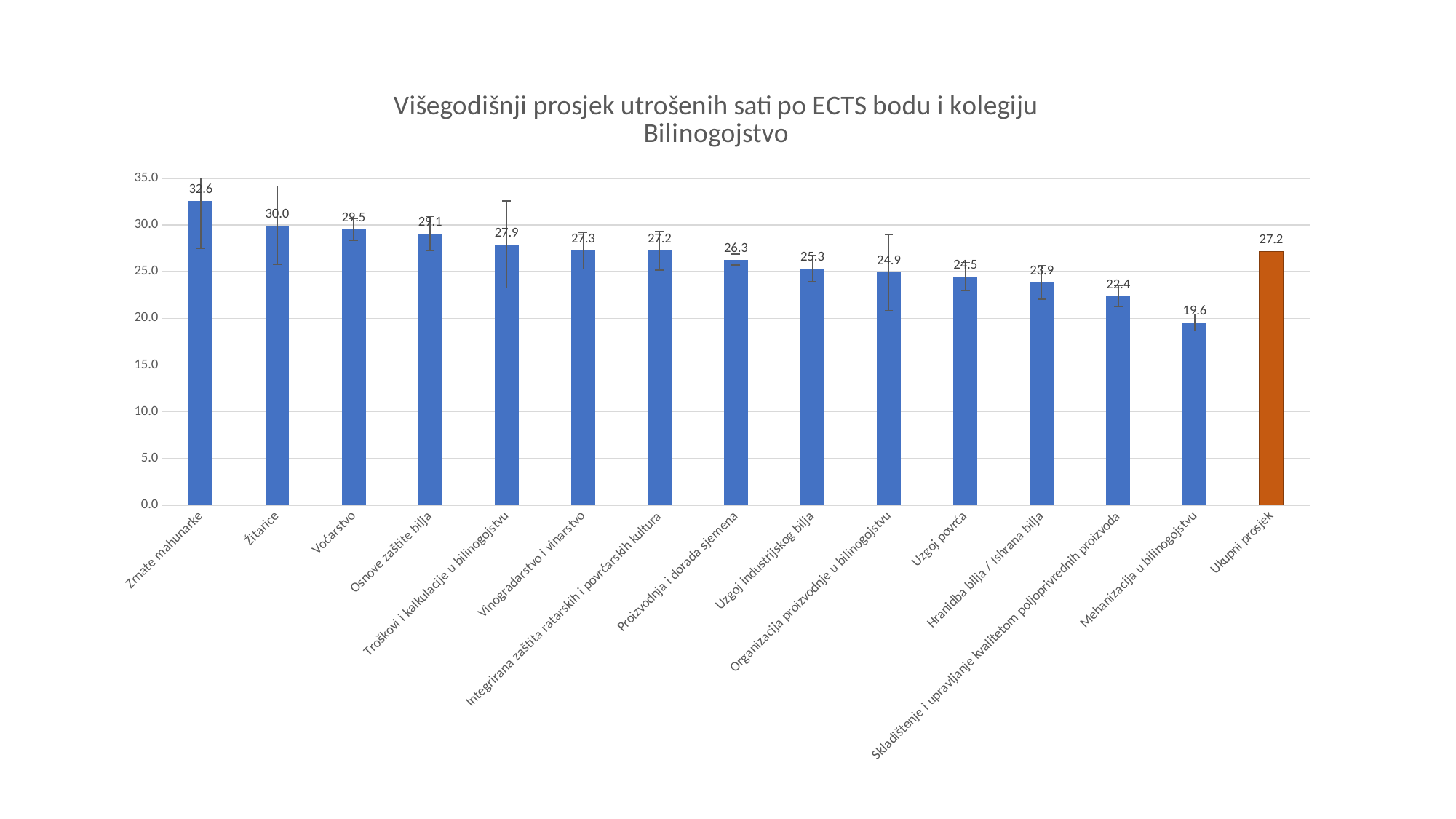
What is the value for Mehanizacija u bilinogojstvu? 19.6 What is the value for Zrnate mahunarke? 32.6 Which bar is shown in a different colour (orange) from the others? Ukupni prosjek Is the value for Skladištenje i upravljanje kvalitetom poljoprivrednih proizvoda greater or less than 25.0? less What is the value for Uzgoj povrća? 24.5 Which category has the lowest value? Mehanizacija u bilinogojstvu Which category has the highest value? Zrnate mahunarke Which is larger, the value for Proizvodnja i dorada sjemena or the value for Uzgoj industrijskog bilja? Proizvodnja i dorada sjemena How many bars are shown in the chart? 15 What is the value for Ukupni prosjek? 27.2 What is the difference between the values for Žitarice and Voćarstvo? 0.5 What kind of chart is shown on the slide? bar chart